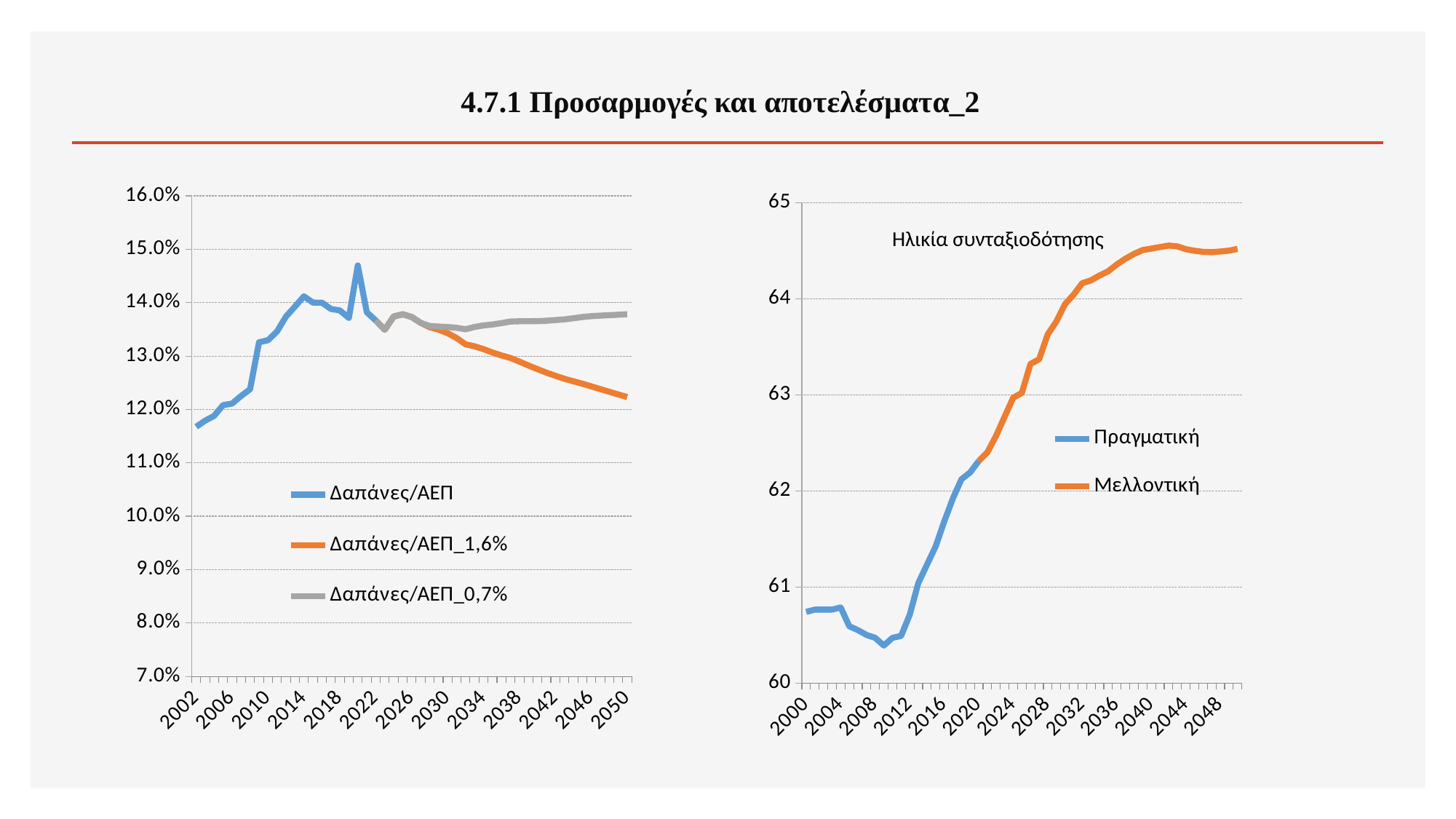
How many series does the legend of the left chart list? 3 In the left chart, is the value of Δαπάνες/ΑΕΠ in 2002 greater or less than 12.0%? less What type of chart is the right chart titled Ηλικία συνταξιοδότησης? line chart In the left chart, is the value of Δαπάνες/ΑΕΠ_0,7% in 2050 greater or less than 13.0%? greater How many series does the legend of the right chart (Ηλικία συνταξιοδότησης) list? 2 In the right chart (Ηλικία συνταξιοδότησης), is the Πραγματική value in 2010 greater or less than 61? less What type of chart is the left chart on the slide? line chart In the left chart, does the Δαπάνες/ΑΕΠ_1,6% series rise or fall from 2030 to 2050? fall In the left chart, which series has the higher value in 2050, Δαπάνες/ΑΕΠ_1,6% or Δαπάνες/ΑΕΠ_0,7%? Δαπάνες/ΑΕΠ_0,7% In the right chart (Ηλικία συνταξιοδότησης), does the Πραγματική series rise or fall from 2012 to 2020? rise